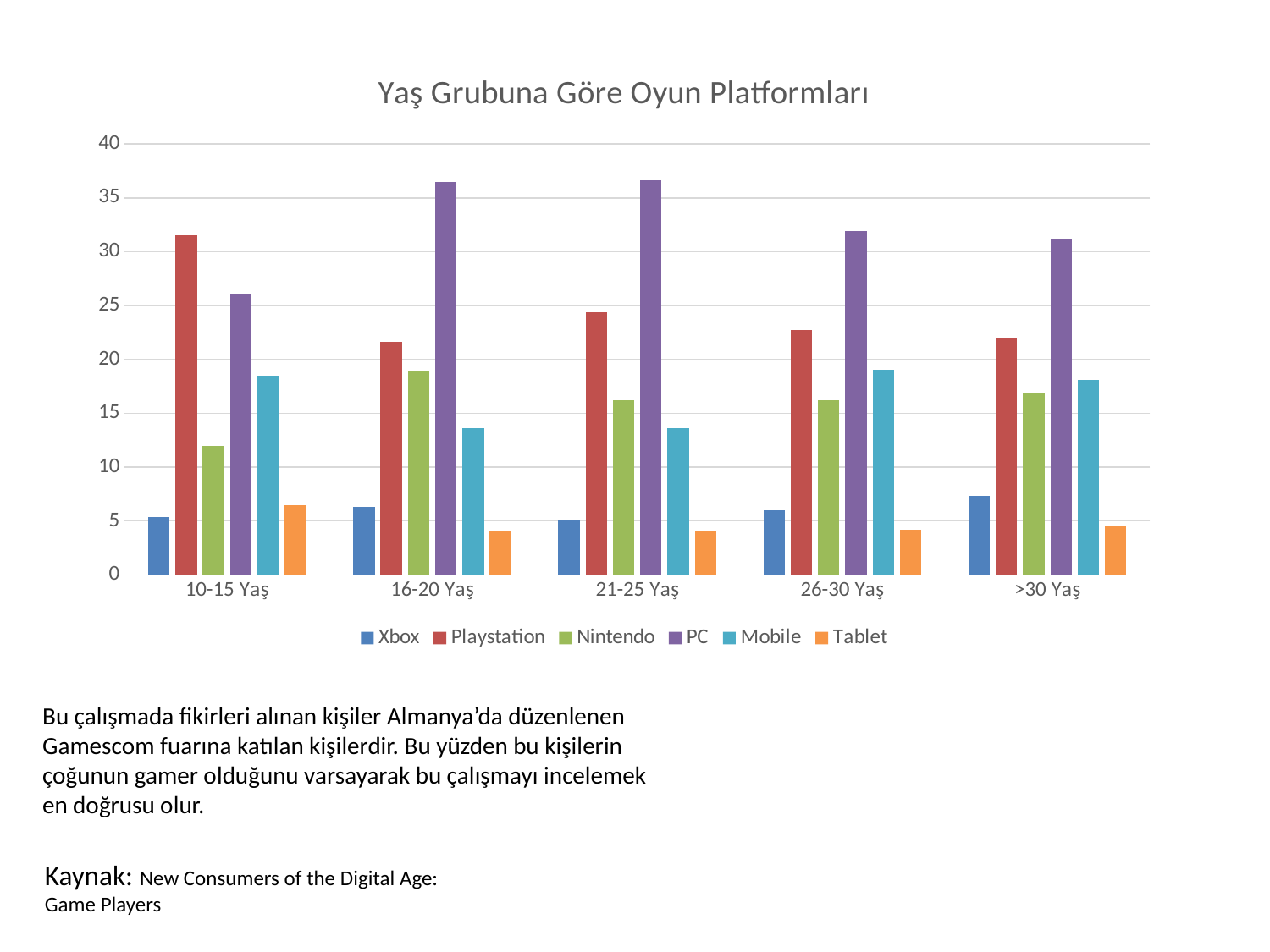
Which platform has the highest value in the 16-20 Yaş group? PC How many age groups are shown on the x axis? 5 What is the title of the chart? Yaş Grubuna Göre Oyun Platformları How many series does the legend list? 6 Is the value for PC in the 16-20 Yaş group greater or less than 35? greater Which platform has the lowest value in the 16-20 Yaş group? Tablet Is the value for Tablet in the 16-20 Yaş group greater or less than 5? less Which platform has the highest value in the 10-15 Yaş group? Playstation In the 10-15 Yaş group, which is larger: Mobile or Nintendo? Mobile What kind of chart is shown on the slide? bar chart Which platform has the lowest value in the 10-15 Yaş group? Xbox In the 21-25 Yaş group, which is larger: Playstation or PC? PC